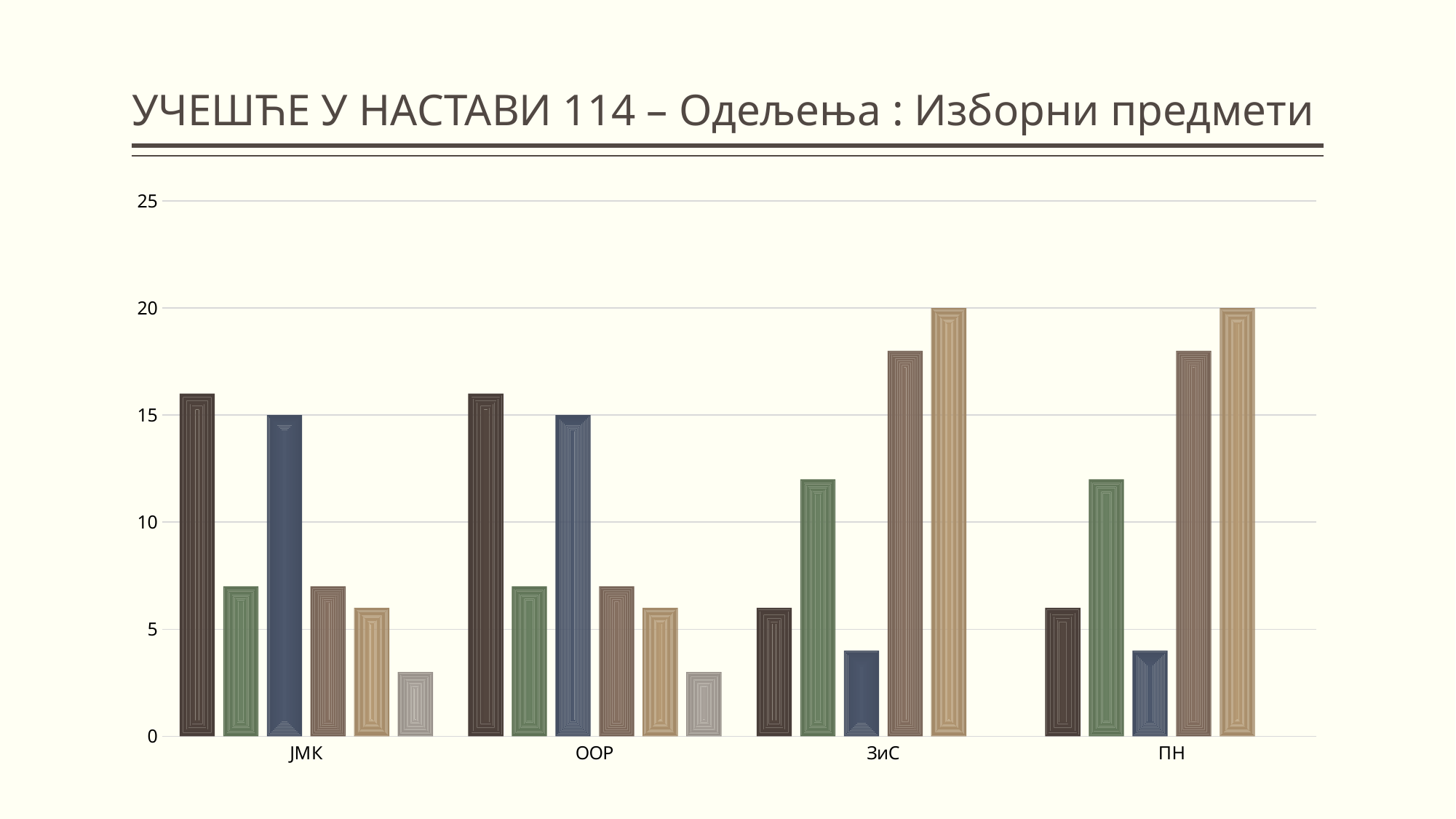
How many categories are shown on the x axis? 4 What is the value of the tallest (light tan) bar for ПН? 20 Is the value of the blue bar for ПН greater or less than 5? less Is the value of the grey bar for ООР greater or less than 5? less What kind of chart is shown on the slide? bar chart What is the value of the blue bar for ЈМК? 15 Which is larger: the dark brown (first) bar for ЈМК or the dark brown (first) bar for ЗиС? ЈМК What is the value of the tallest (light tan) bar for ЗиС? 20 Is the value of the dark brown (first) bar for ЈМК greater or less than 15? greater What is the value of the blue bar for ООР? 15 How many bars are shown for the category ЗиС? 5